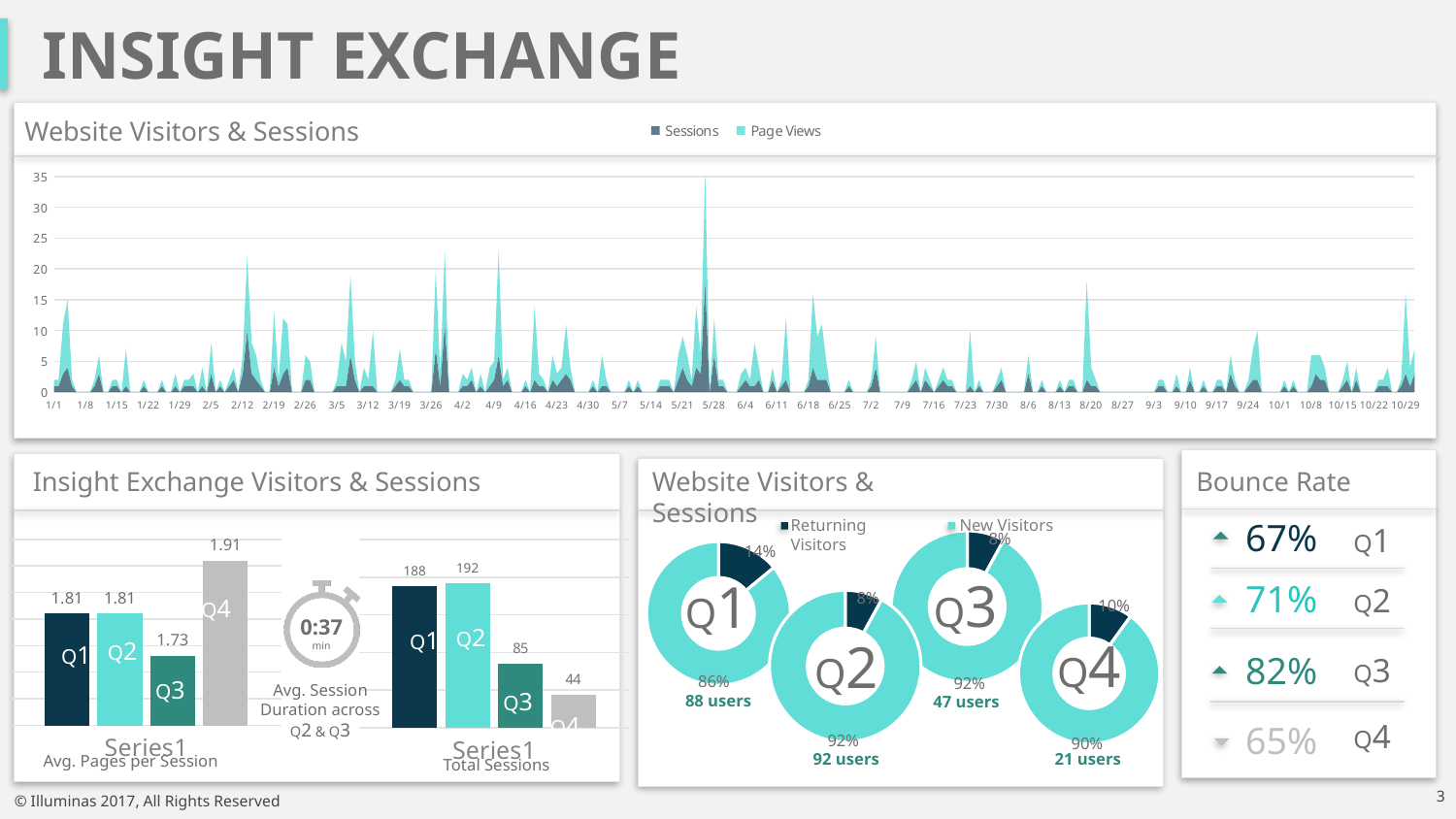
How many series does the legend of the top Website Visitors & Sessions chart list? 2 In the Total Sessions bar chart, what is the value for Q2? 192 In the Total Sessions bar chart, which quarter has the lowest value? Q4 In the Avg. Pages per Session bar chart, which quarter has the highest value? Q4 In the Bounce Rate panel, what is the bounce rate for Q3? 82% In the Total Sessions bar chart, what is the difference between Q1 and Q3? 103 In the Avg. Pages per Session bar chart, how many bars are shown? 4 In the Bounce Rate panel, which quarter has the lowest bounce rate? Q4 In the Website Visitors & Sessions donut charts, what share of the Q4 donut is the larger slice? 90% In the Website Visitors & Sessions donut charts, how many users are shown for Q2? 92 users What kind of chart is the Total Sessions chart in the Insight Exchange Visitors & Sessions panel? Bar chart In the Avg. Pages per Session bar chart, what is the value for Q3? 1.73